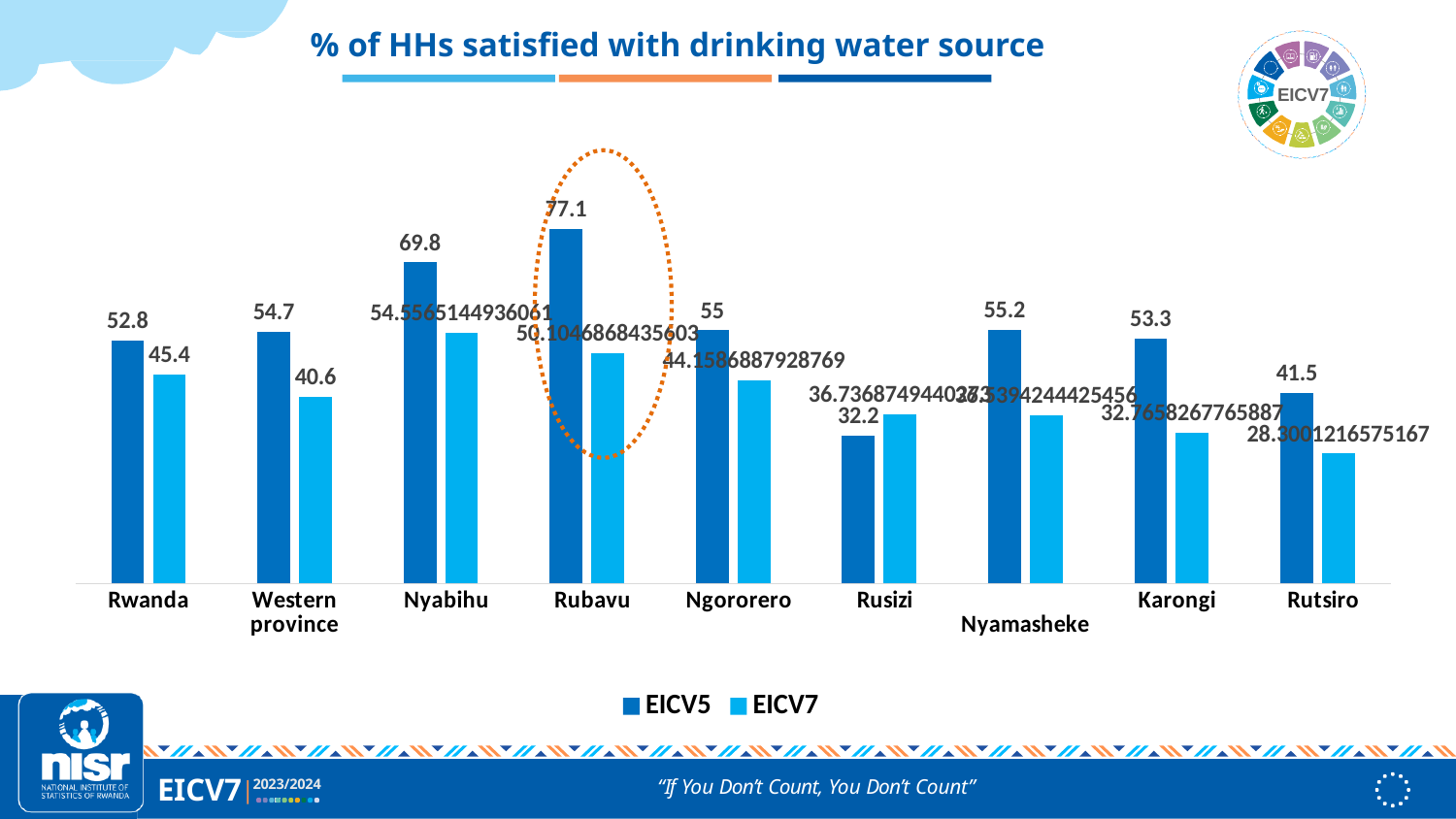
How many categories are shown on the x axis? 9 What is the difference between the EICV5 and EICV7 values for Rwanda? 7.4 Which is larger, the EICV5 value for Nyabihu or the EICV5 value for Rubavu? Rubavu What is the EICV5 value for Rubavu? 77.1 How many series does the legend list? 2 What is the EICV5 value for Rusizi? 32.2 What is the EICV7 value for Western province? 40.6 Which category has the lowest EICV5 value? Rusizi What is the difference between the EICV5 and EICV7 values for Western province? 14.1 Which category has the highest EICV5 value? Rubavu What is the EICV5 value for Rwanda? 52.8 For Rusizi, which series has the larger value, EICV5 or EICV7? EICV7